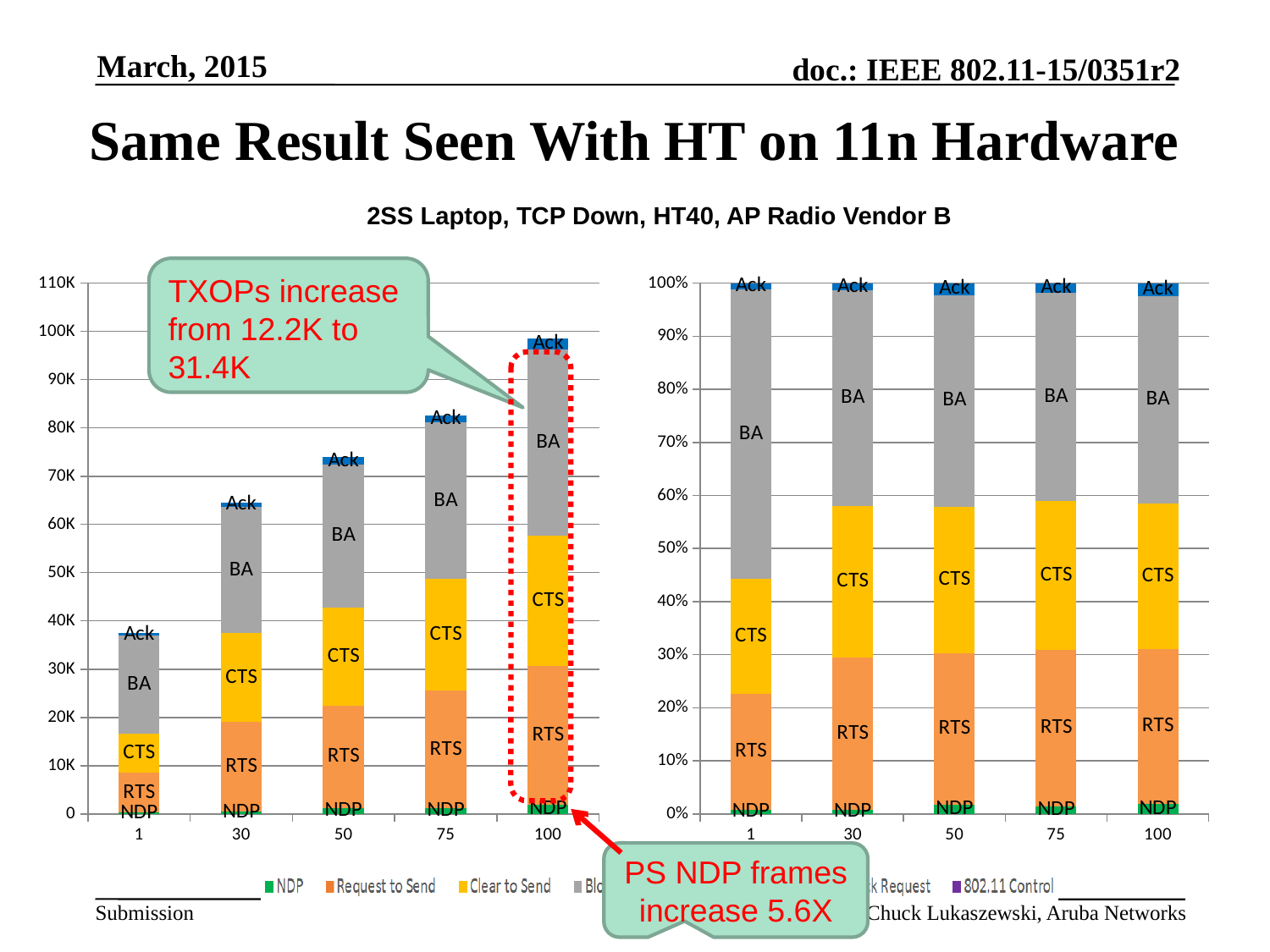
What kind of chart is the left chart on the slide? Stacked bar chart In the left chart, which category has the shortest stacked bar? 1 What is the subtitle printed above the charts describing the test setup? 2SS Laptop, TCP Down, HT40, AP Radio Vendor B In the left chart, do the total bar heights rise or fall as you move from category 1 to category 100? Rise In the right chart, is the BA share for category 1 greater or less than 50%? greater How many categories are shown on the x axis of the left chart? 5 In the left chart, is the total bar height for category 30 greater or less than 60K? greater In the left chart, is the total bar height for category 100 greater or less than 90K? greater In the left chart, which category has the tallest stacked bar? 100 In the right chart, which has the larger RTS share: category 1 or category 100? 100